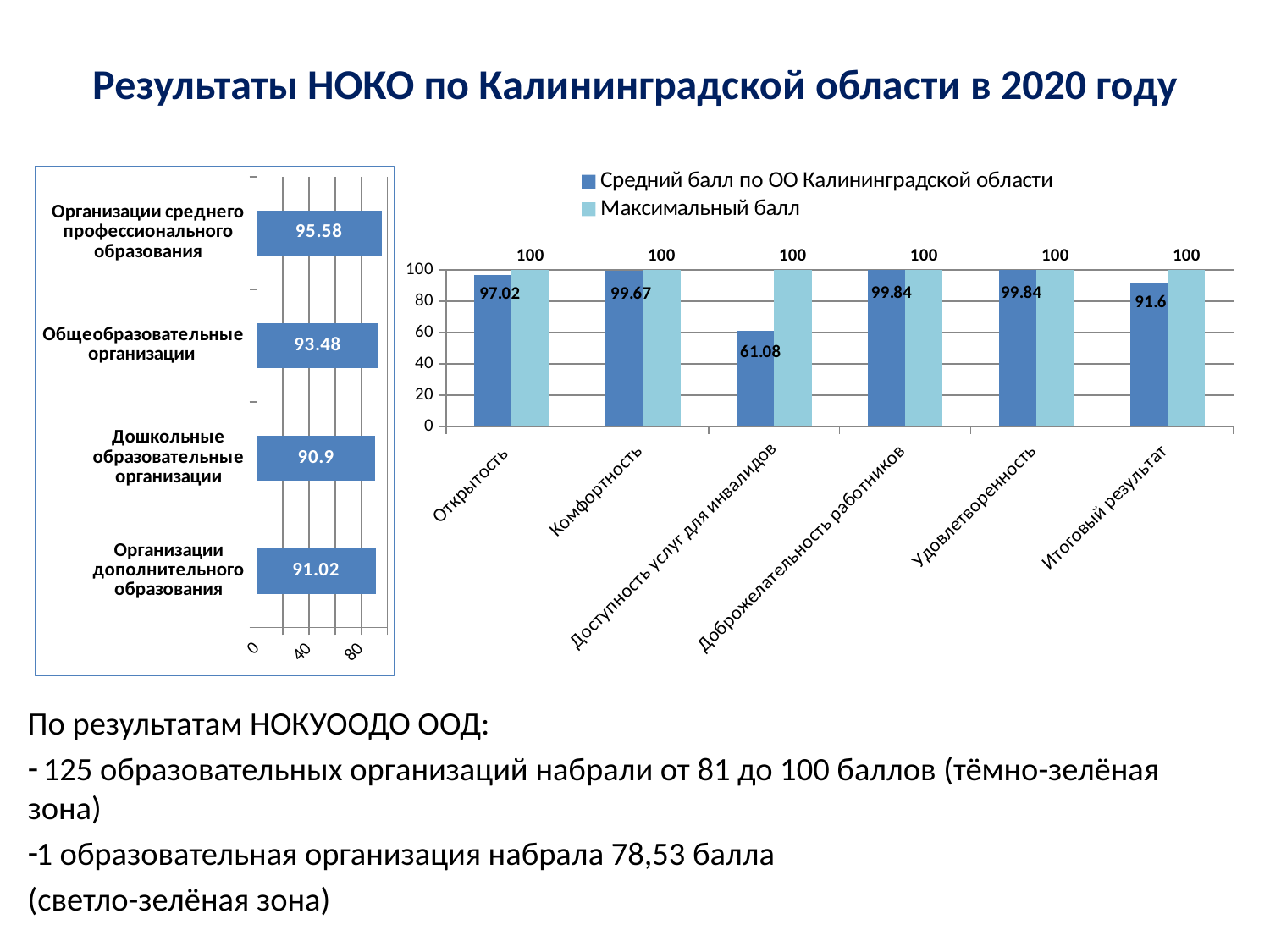
In the right chart, which category has the lowest Средний балл по ОО Калининградской области? Доступность услуг для инвалидов In the left chart, which category has the lowest value? Дошкольные образовательные организации What kind of chart is the left chart? Bar chart In the left chart, what is the difference between the values for Организации среднего профессионального образования and Организации дополнительного образования? 4.56 In the right chart, what is the value of Средний балл по ОО Калининградской области for Доступность услуг для инвалидов? 61.08 In the left chart, what is the value for Общеобразовательные организации? 93.48 In the right chart, is the Средний балл по ОО Калининградской области for Комфортность larger or smaller than for Итоговый результат? Larger How many categories does the left chart show? 4 How many series does the legend of the right chart list? 2 In the right chart, what is the difference between Максимальный балл and Средний балл по ОО Калининградской области for Открытость? 2.98 In the left chart, which category has the highest value? Организации среднего профессионального образования In the right chart, what is the value of Средний балл по ОО Калининградской области for Итоговый результат? 91.6